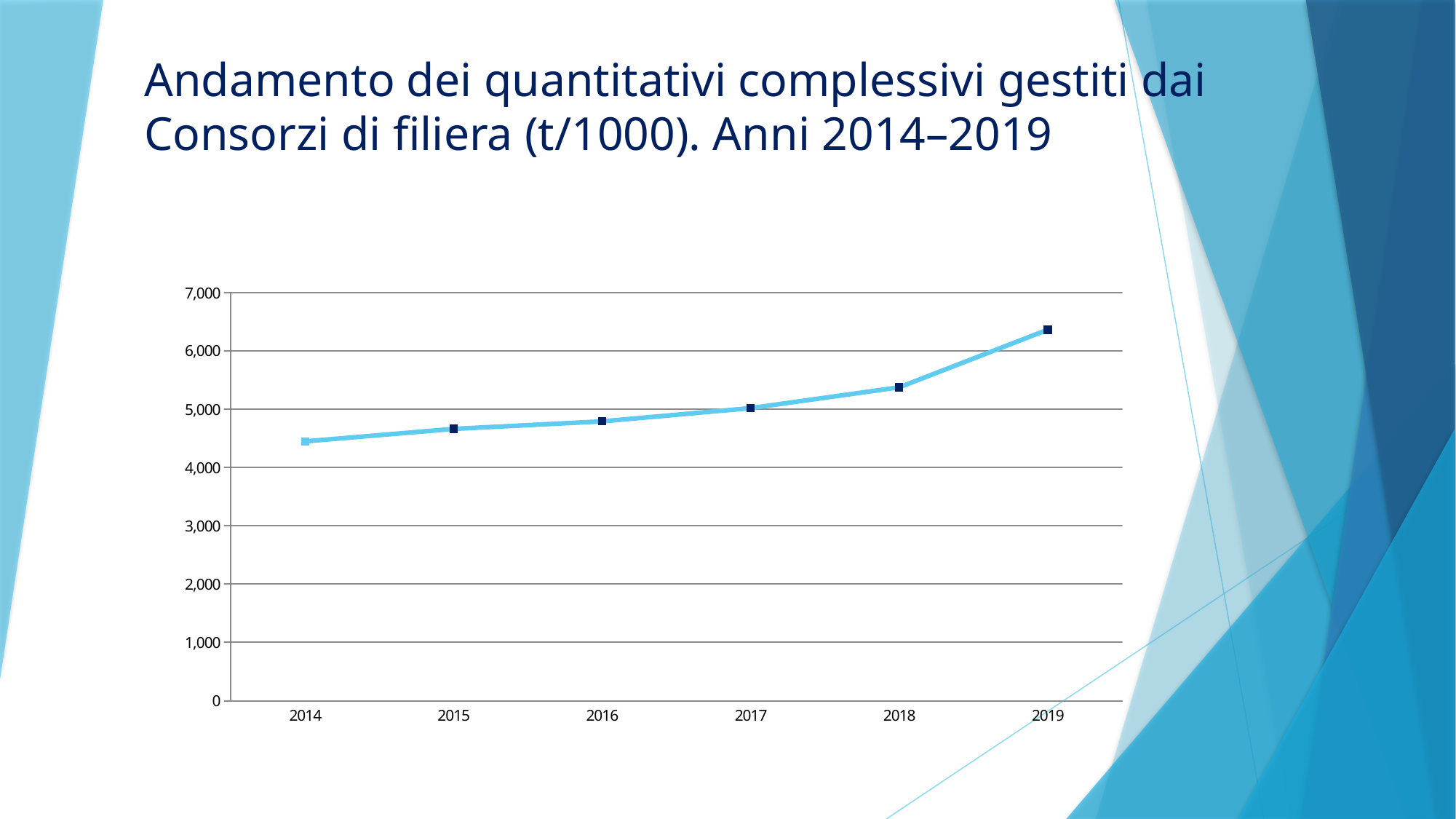
Which year has the highest value in the chart? 2019 Which year has the lowest value in the chart? 2014 Which is larger, the value for 2018 or the value for 2015? 2018 What unit is stated in the slide title for the quantities plotted? t/1000 Do the values rise or fall from 2014 to 2019? rise What is the highest tick value shown on the y axis? 7,000 Is the value for 2014 greater or less than 5,000? less Is the value for 2019 greater or less than 6,000? greater How many years are plotted on the x axis of the chart? 6 What kind of chart is shown on the slide? line chart Is the value for 2016 greater or less than 5,000? less